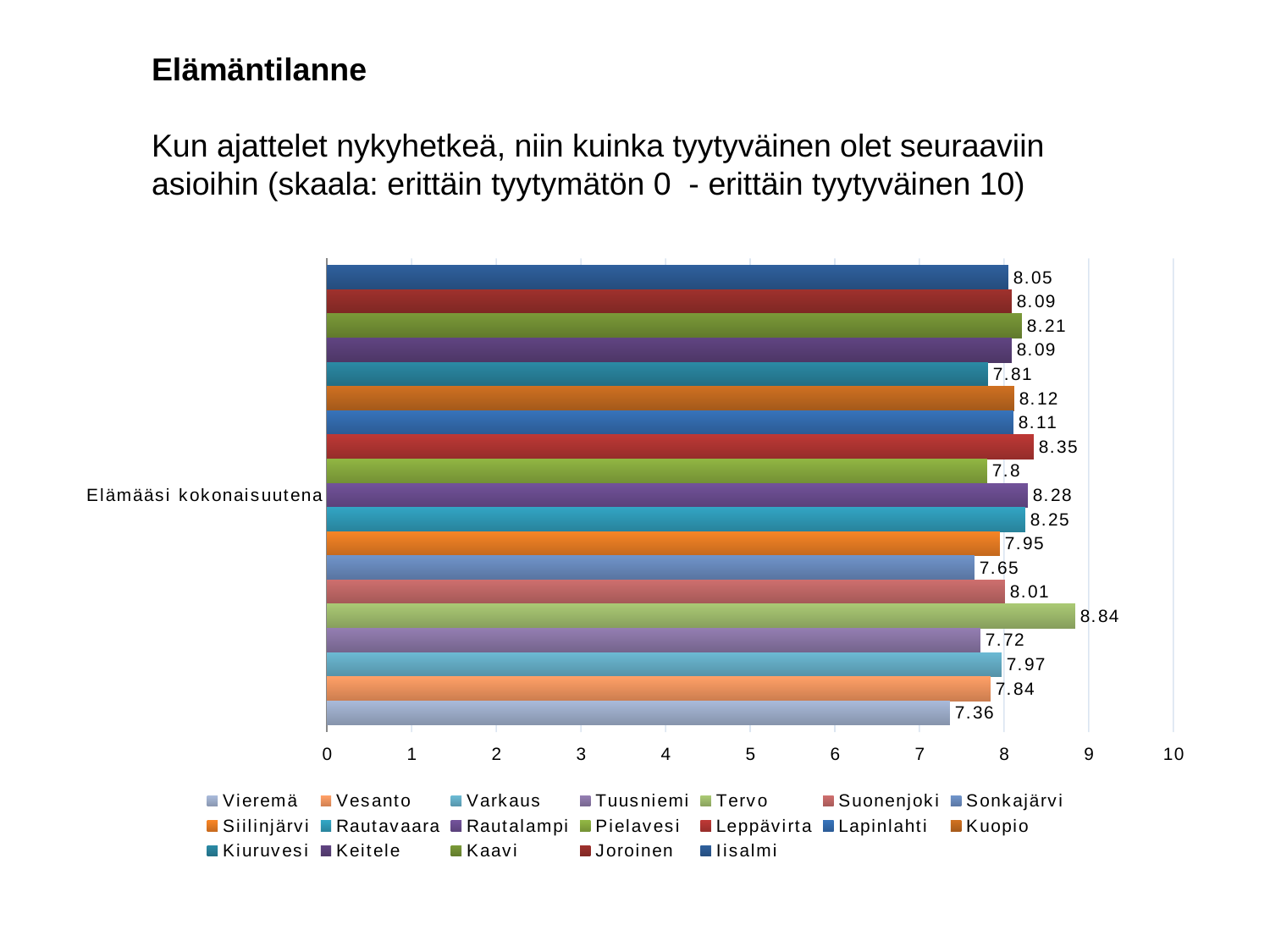
Which municipality has the highest value? Tervo What is the value for Tervo? 8.84 What is the difference between the values for Tervo and Vieremä? 1.48 Which has a larger value, Rautalampi or Sonkajärvi? Rautalampi What is the maximum value shown on the horizontal axis? 10 How many series does the legend list? 19 What is the category label shown on the vertical axis? Elämääsi kokonaisuutena What is the value for Leppävirta? 8.35 What kind of chart is shown on the slide? bar chart Which municipality has the lowest value? Vieremä What is the value for Kuopio? 8.12 What is the value for Vieremä? 7.36